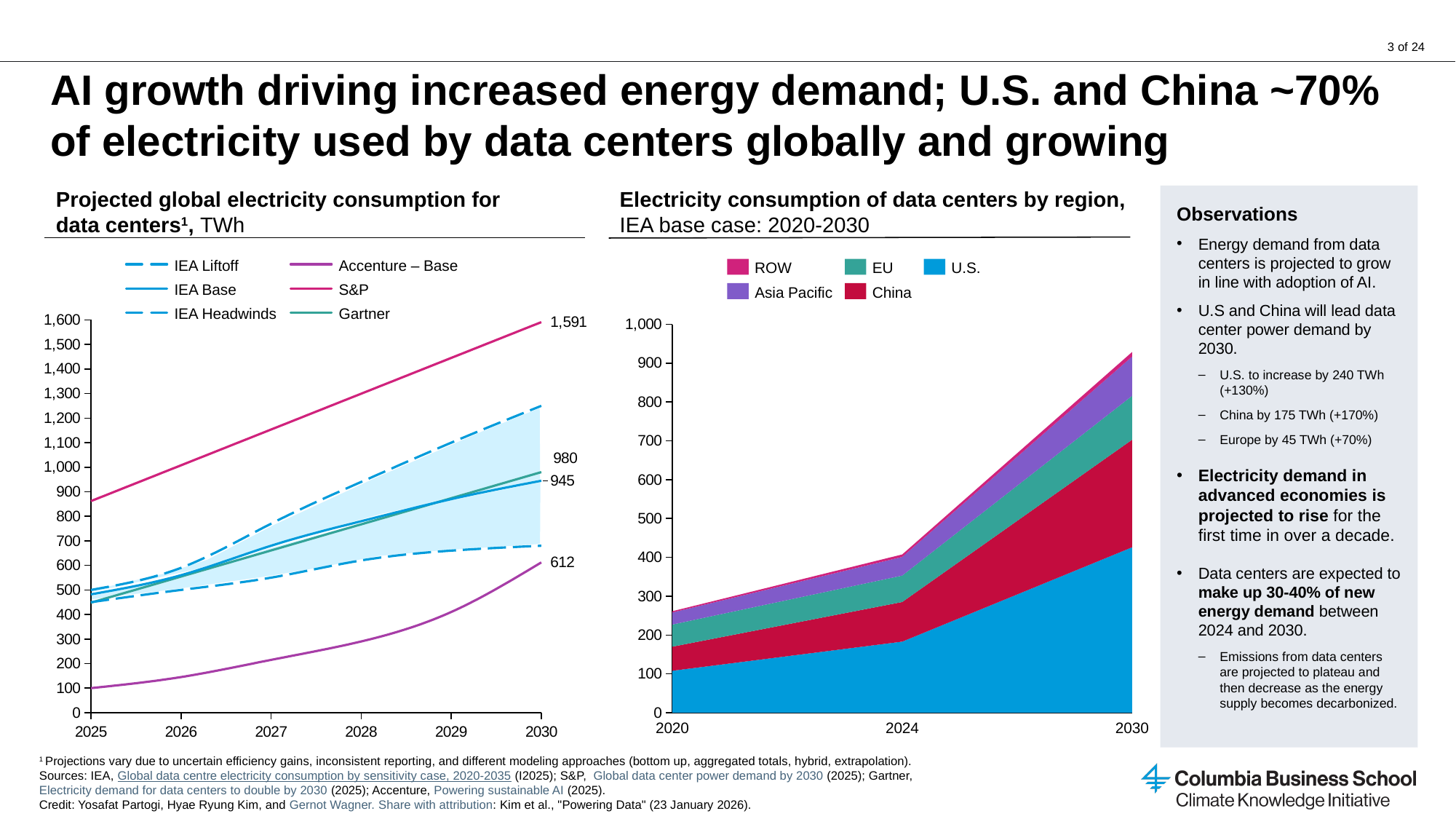
In the right chart (Electricity consumption of data centers by region), is the total consumption in 2030 greater or less than 800? greater How many series does the legend of the left chart (Projected global electricity consumption for data centers) list? 6 In the left chart (Projected global electricity consumption for data centers), which series has the highest value in 2030? S&P In the left chart (Projected global electricity consumption for data centers), what is the difference between the S&P and IEA Base values in 2030? 646 In the left chart (Projected global electricity consumption for data centers), which series has the lowest value in 2030? Accenture – Base In the left chart (Projected global electricity consumption for data centers), what is the Accenture – Base value for 2030? 612 In the left chart (Projected global electricity consumption for data centers), what is the IEA Base value for 2030? 945 In the left chart (Projected global electricity consumption for data centers), which is larger in 2030: Gartner or IEA Base? Gartner In the right chart (Electricity consumption of data centers by region), which region has the largest consumption in 2030? U.S. How many regions does the legend of the right chart (Electricity consumption of data centers by region) list? 5 In the left chart (Projected global electricity consumption for data centers), what is the S&P value for 2030? 1,591 What kind of chart is the right chart (Electricity consumption of data centers by region)? Stacked area chart